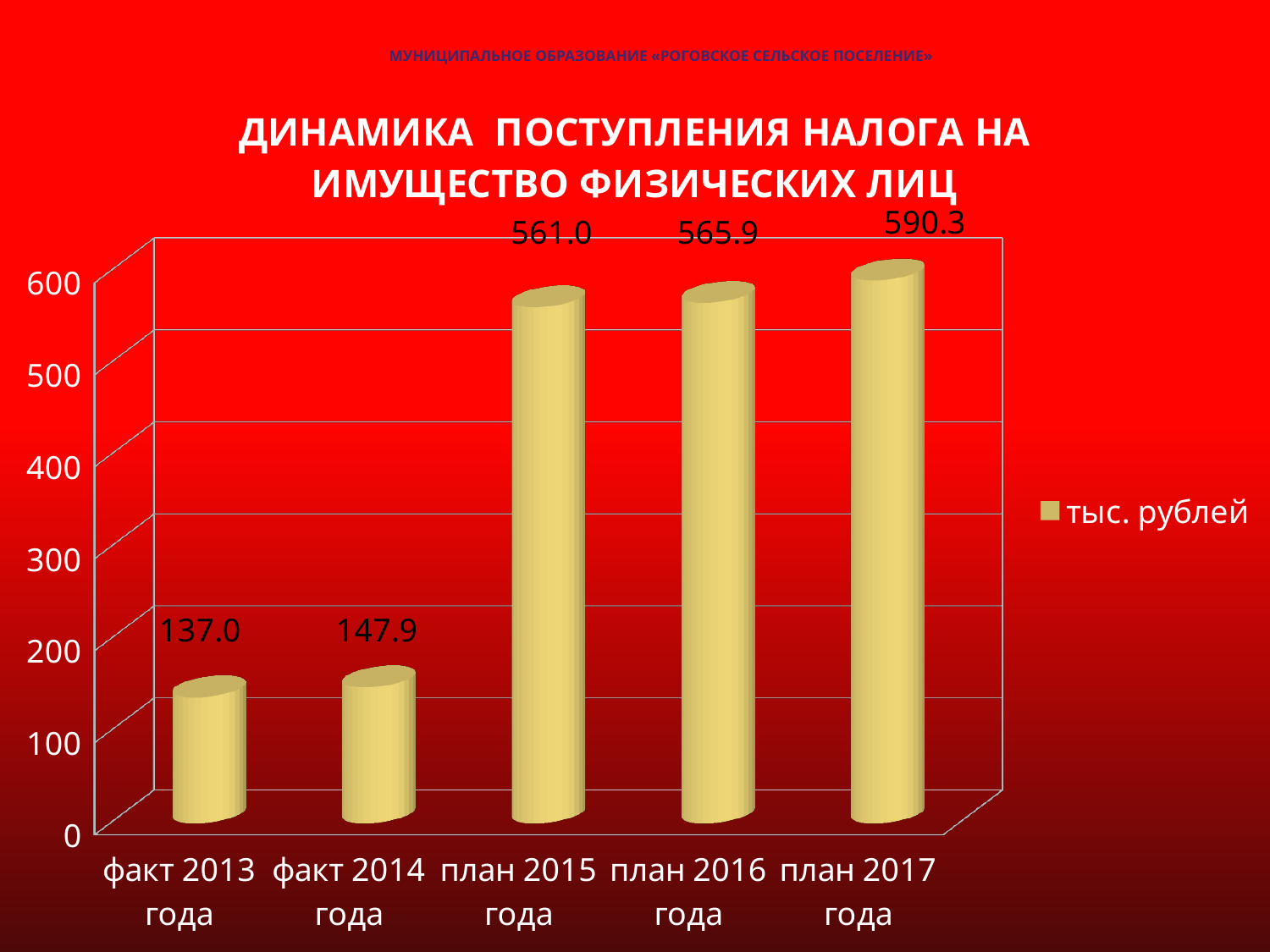
Which category has the highest value? план 2017 года Is the value for план 2016 года greater or less than 500? greater What is the legend entry for the series? тыс. рублей What is the value for факт 2013 года? 137.0 How many categories are shown on the x axis? 5 Which category has the lowest value? факт 2013 года What kind of chart is shown on the slide? bar chart What is the value for план 2017 года? 590.3 What is the difference between the values for факт 2014 года and факт 2013 года? 10.9 What is the difference between the values for план 2015 года and факт 2014 года? 413.1 Which is larger, the value for план 2015 года or the value for план 2017 года? план 2017 года What is the value for план 2016 года? 565.9